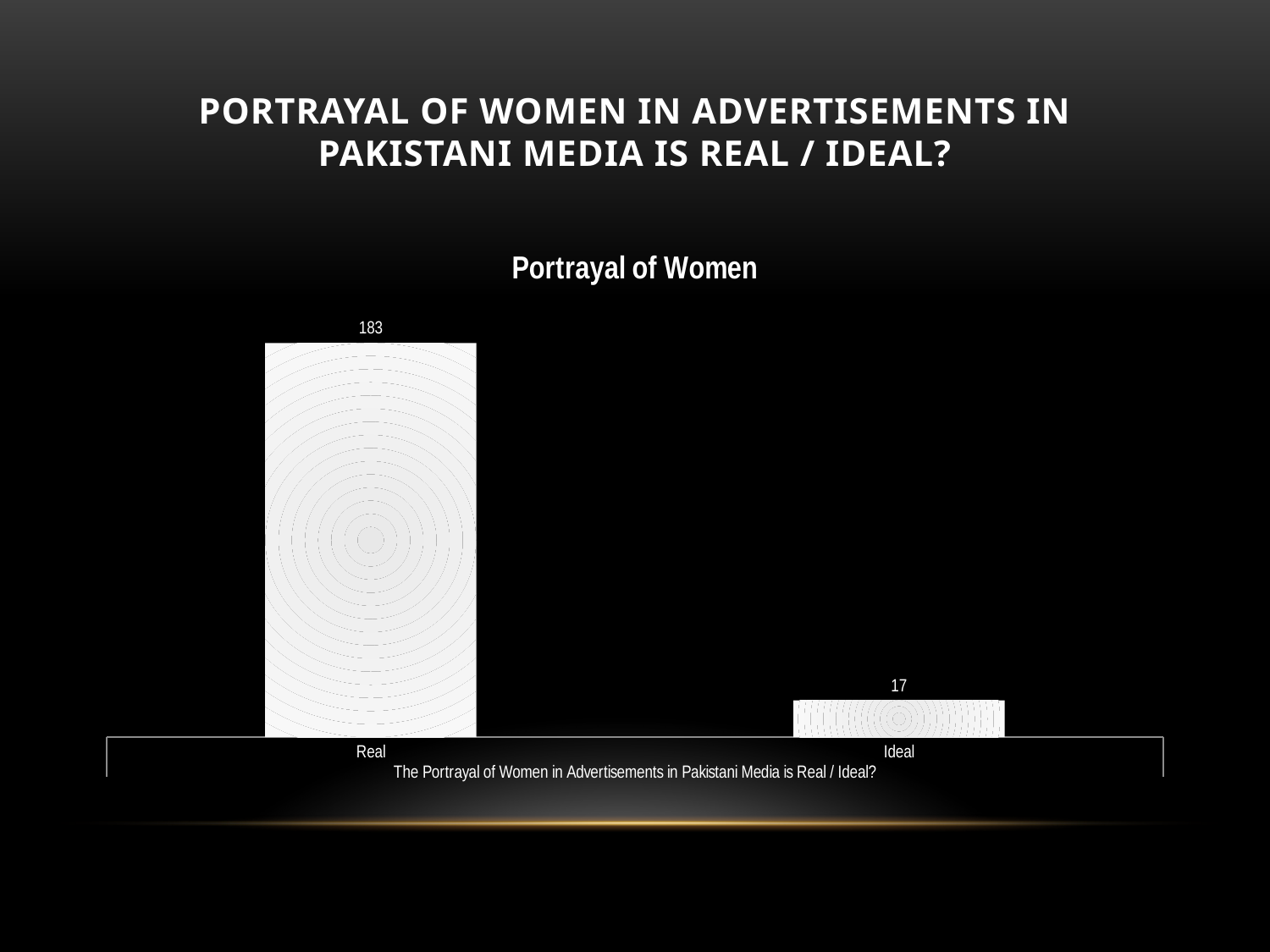
How many categories are shown on the x axis? 2 Which category has the highest value? Real What is the difference between the values for Real and Ideal? 166 What is the title of the chart? Portrayal of Women What is the value for Real? 183 What is the x axis title of the chart? The Portrayal of Women in Advertisements in Pakistani Media is Real / Ideal? Which category has the lowest value? Ideal What is the value for Ideal? 17 What is the total of the values for Real and Ideal? 200 What kind of chart is shown? bar chart Which is larger, the value for Real or the value for Ideal? Real